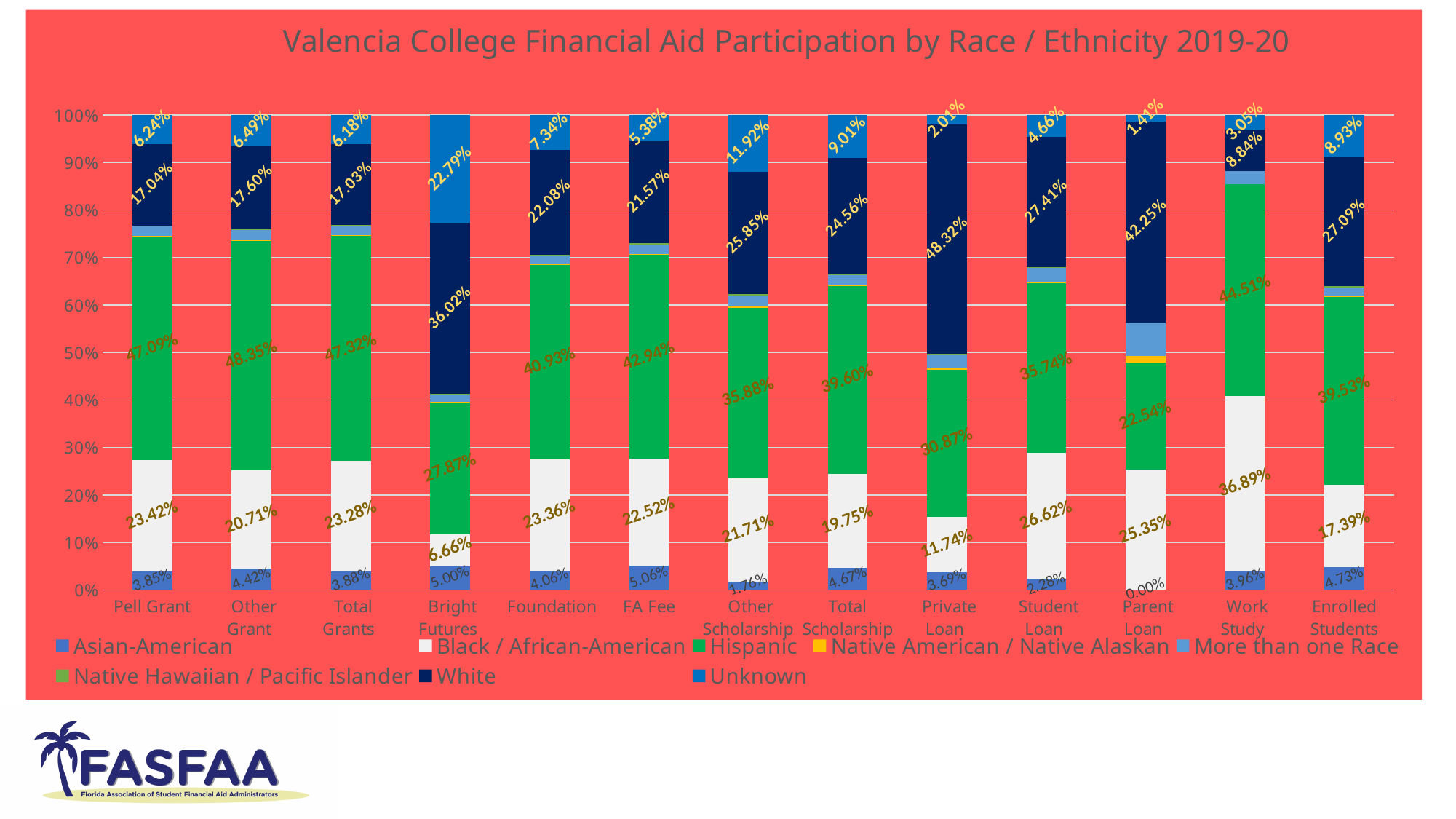
What is the White share for Private Loan? 48.32% What is the difference between the White share for Parent Loan and the White share for Work Study? 33.41% What is the Unknown share for Bright Futures? 22.79% Which category has the lowest Asian-American share? Parent Loan How many categories are shown on the x axis? 13 Which is larger for Student Loan: the Black / African-American share or the White share? White Which category has the highest Hispanic share? Other Grant What is the title of the chart? Valencia College Financial Aid Participation by Race / Ethnicity 2019-20 What is the Hispanic share for Pell Grant? 47.09% How many series does the legend list? 8 What kind of chart is this? Stacked bar chart What is the Black / African-American share for Work Study? 36.89%